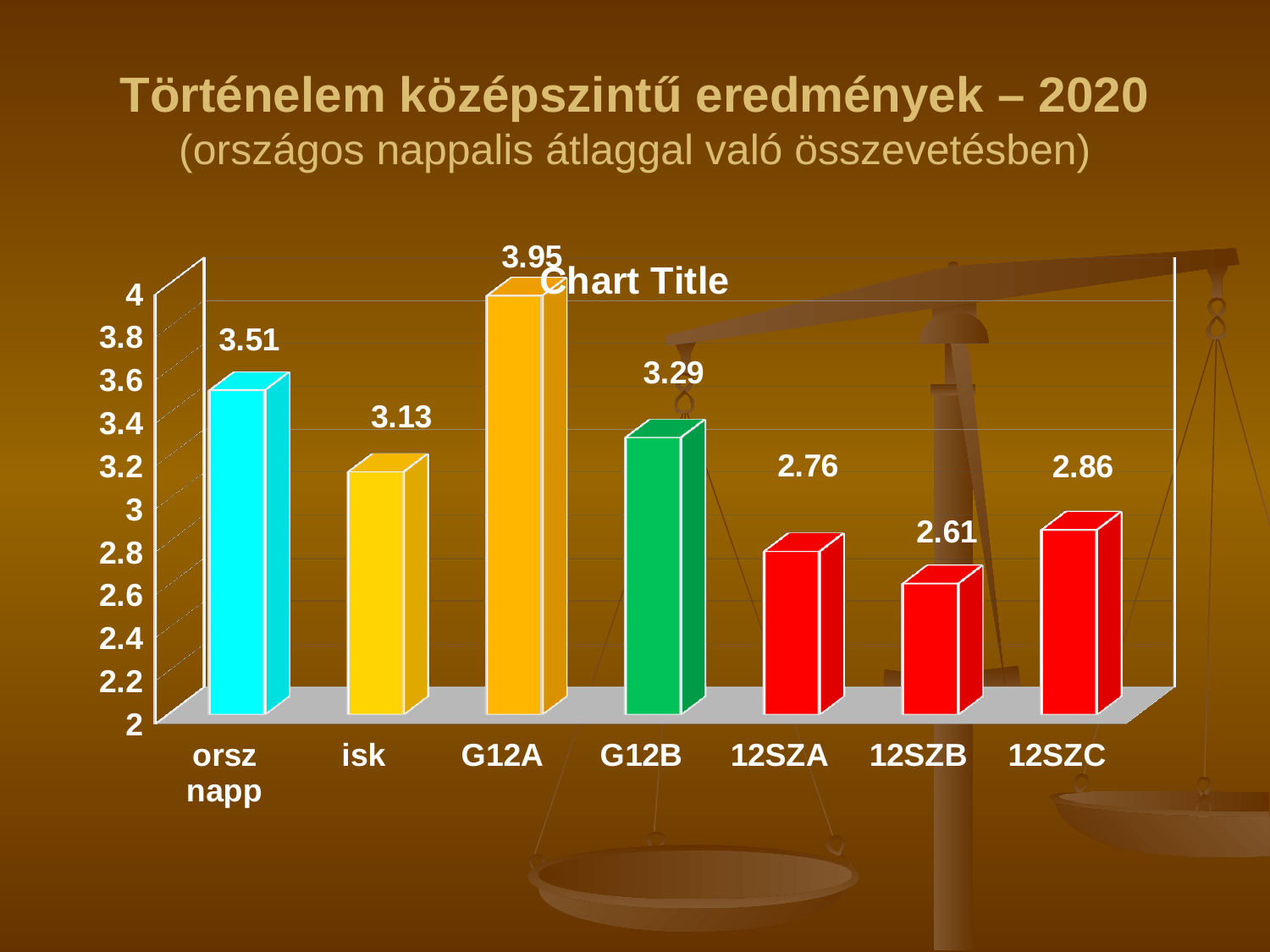
Which is larger, the value for 12SZA or the value for 12SZC? 12SZC What is the difference between the values for orsz napp and isk? 0.38 What is the value for isk? 3.13 Which category has the highest value? G12A What kind of chart is shown on the slide? bar chart What is the value for 12SZB? 2.61 What is the difference between the values for G12A and G12B? 0.66 What is the value for G12A? 3.95 Is the value for G12B greater or less than 3? greater Which category has the lowest value? 12SZB What is the value for orsz napp? 3.51 How many categories are shown on the x axis? 7